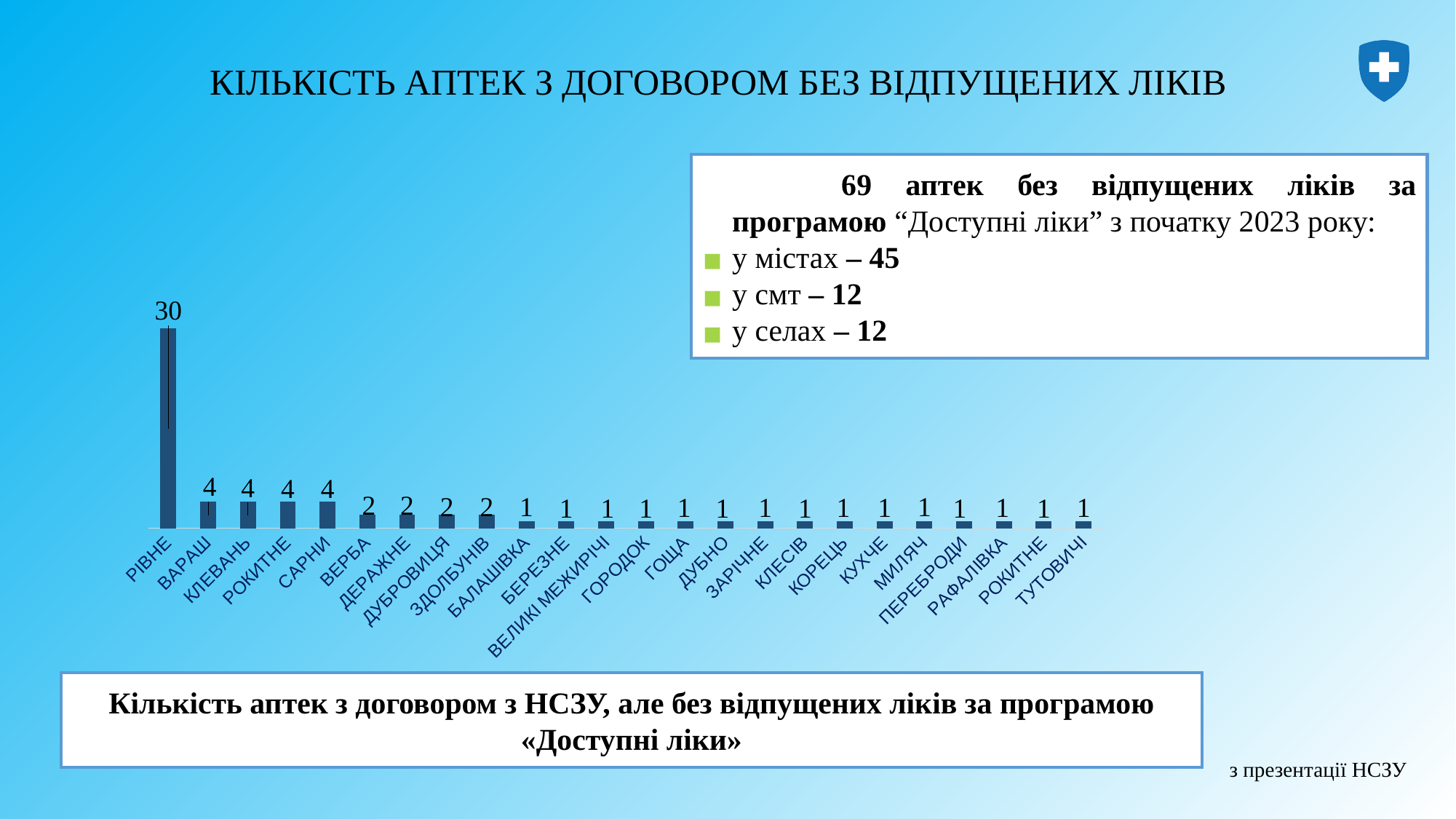
Is the value for РІВНЕ greater or less than 20? greater Which is larger, the value for ЗДОЛБУНІВ or the value for КОРЕЦЬ? ЗДОЛБУНІВ How many categories are shown on the x axis of the chart? 24 What is the difference between the values for РІВНЕ and КЛЕВАНЬ? 26 What is the value for САРНИ? 4 What type of chart is shown on the slide? bar chart What is the value for ВАРАШ? 4 Which category has the highest value in the chart? РІВНЕ What is the value for РІВНЕ? 30 What is the value for ДУБРОВИЦЯ? 2 What is the difference between the values for ВАРАШ and ВЕРБА? 2 What is the value for ГОЩА? 1